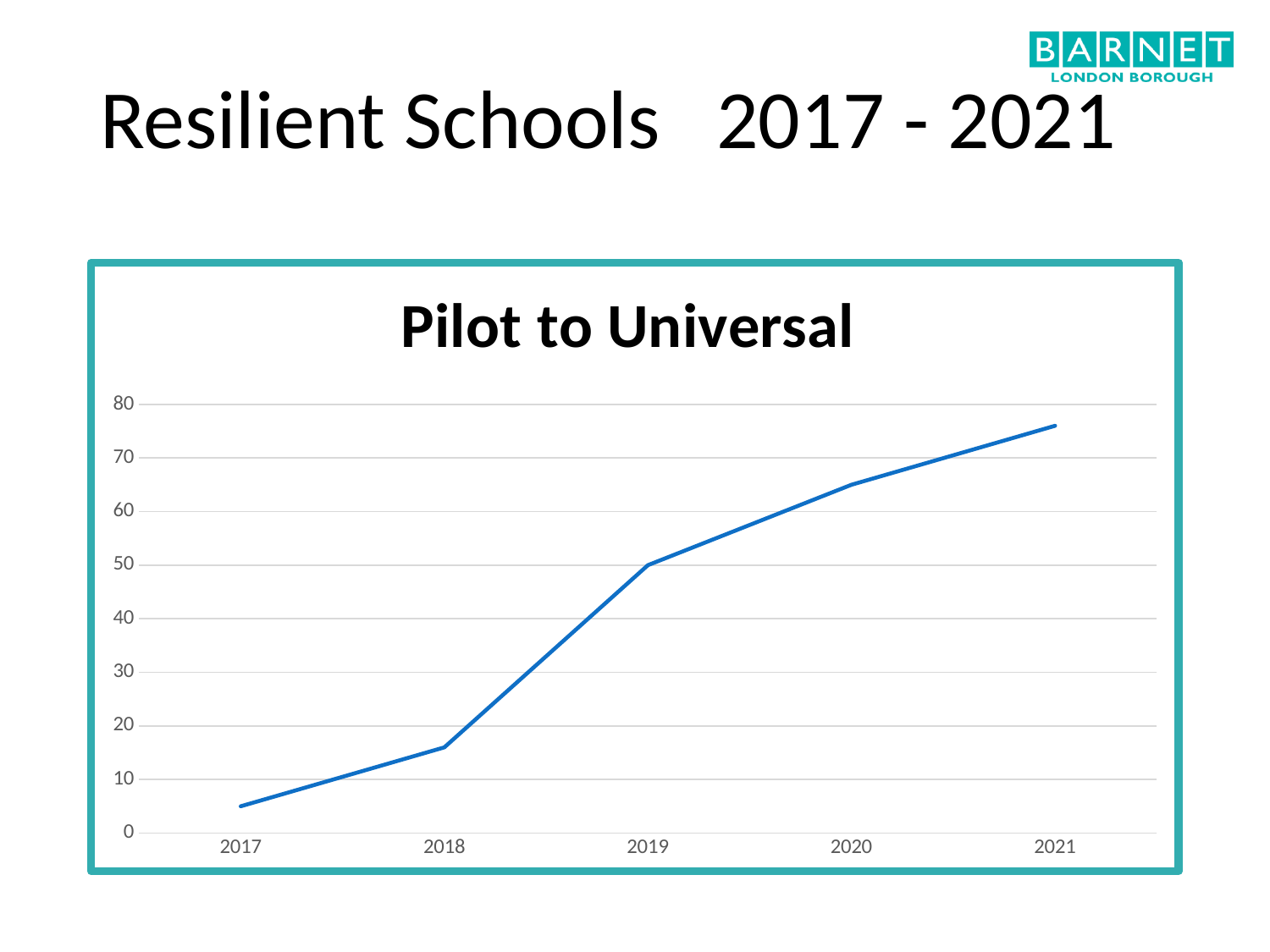
What is the highest value shown on the y axis of the chart? 80 What kind of chart is shown on the slide? line chart Is the value for 2018 greater or less than 20? less Which year has the highest value in the chart? 2021 Which year has the lowest value in the chart? 2017 What is the title of the chart? Pilot to Universal Is the value for 2020 greater or less than 60? greater Is the value for 2021 greater or less than 70? greater Do the values rise or fall from 2017 to 2021? rise How many years are plotted on the x axis of the chart? 5 Which is larger, the value for 2019 or the value for 2018? 2019